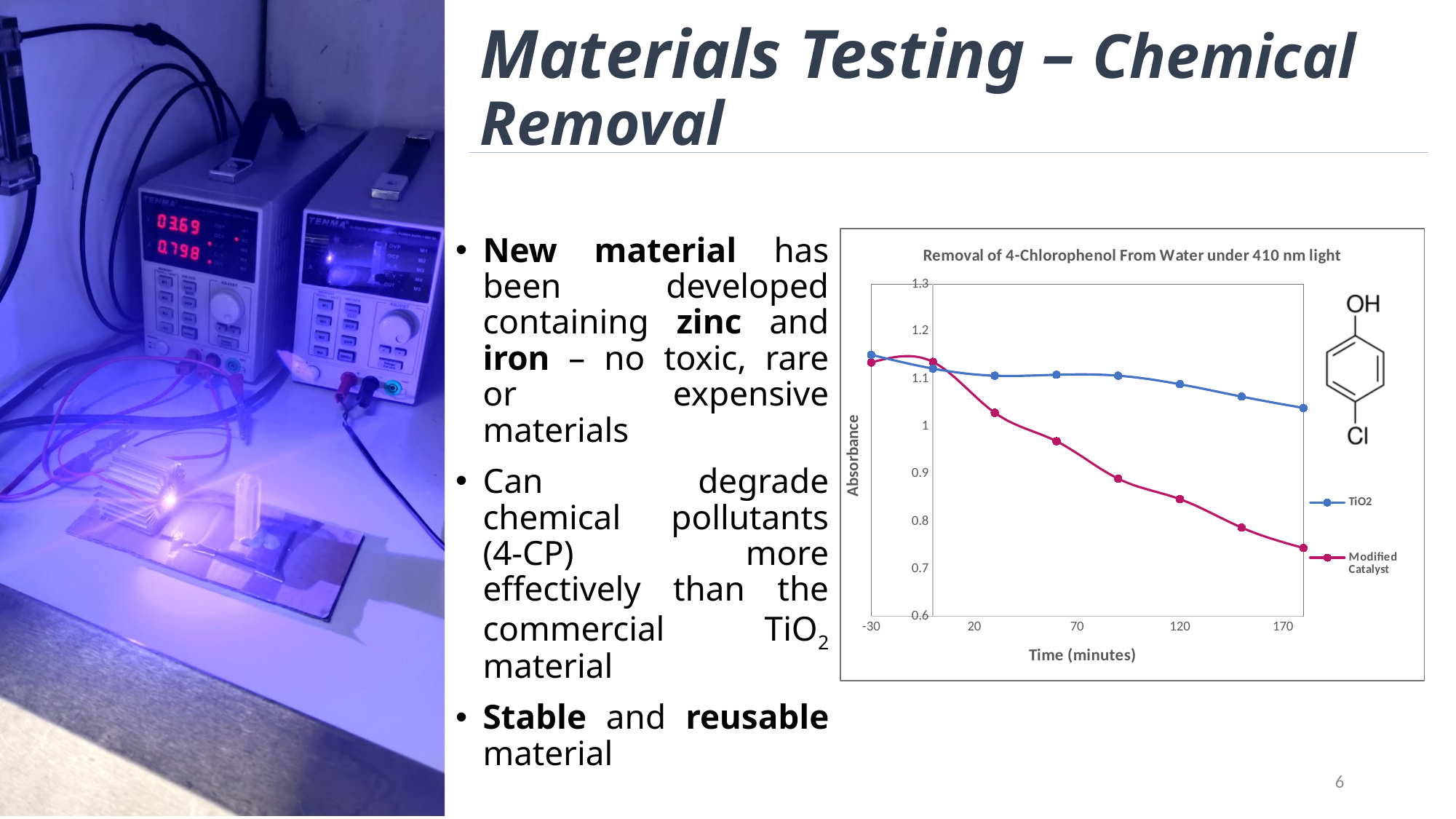
At the final time point, is the absorbance for the Modified Catalyst greater or less than 0.8? less At the final time point, is the absorbance for TiO2 greater or less than 1? greater At 120 minutes, is the absorbance for the Modified Catalyst greater or less than 0.9? less What is the label of the x axis of the chart? Time (minutes) Does the TiO2 series rise or fall overall as time increases? fall Which series has the lower absorbance at the final time point? Modified Catalyst What are the two series named in the chart legend? TiO2 and Modified Catalyst How many series does the legend of the chart list? 2 What is the title of the chart? Removal of 4-Chlorophenol From Water under 410 nm light What kind of chart is shown on the slide? line chart How many data points are plotted for the Modified Catalyst series? 8 Does the Modified Catalyst series rise or fall as time increases? fall